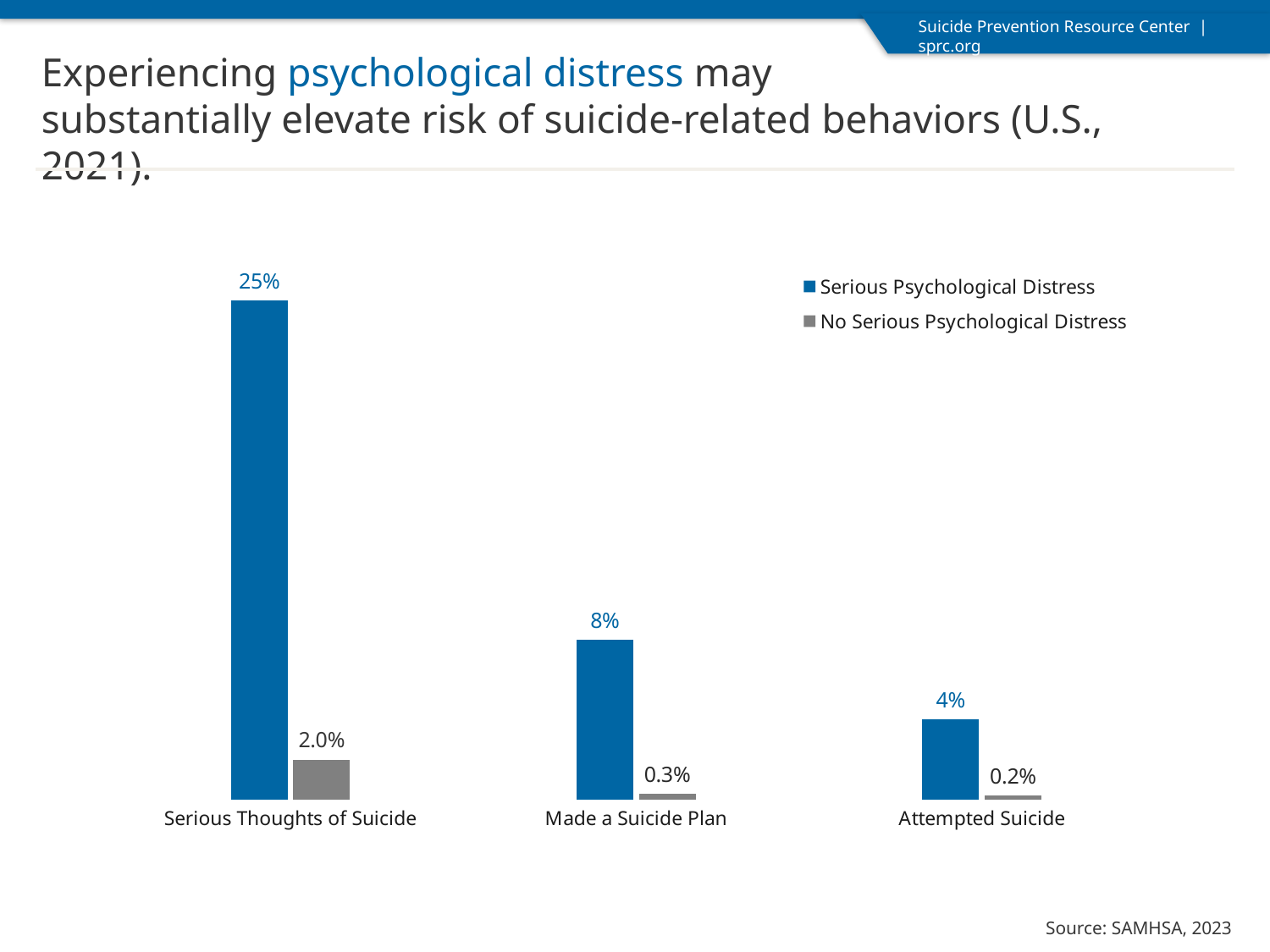
What kind of chart is shown on the slide? Bar chart What is the value for No Serious Psychological Distress in the Attempted Suicide category? 0.2% Which is larger in the Attempted Suicide category: Serious Psychological Distress or No Serious Psychological Distress? Serious Psychological Distress Which category has the highest value for Serious Psychological Distress? Serious Thoughts of Suicide What is the value for Serious Psychological Distress in the Serious Thoughts of Suicide category? 25% Which category has the lowest value for No Serious Psychological Distress? Attempted Suicide What is the difference between the Serious Psychological Distress and No Serious Psychological Distress values for Made a Suicide Plan? 7.7% What is the value for Serious Psychological Distress in the Made a Suicide Plan category? 8% How many categories are shown on the x axis? 3 What is the value for No Serious Psychological Distress in the Serious Thoughts of Suicide category? 2.0% Do the Serious Psychological Distress values rise or fall from left to right across the categories? Fall How many series does the legend list? 2